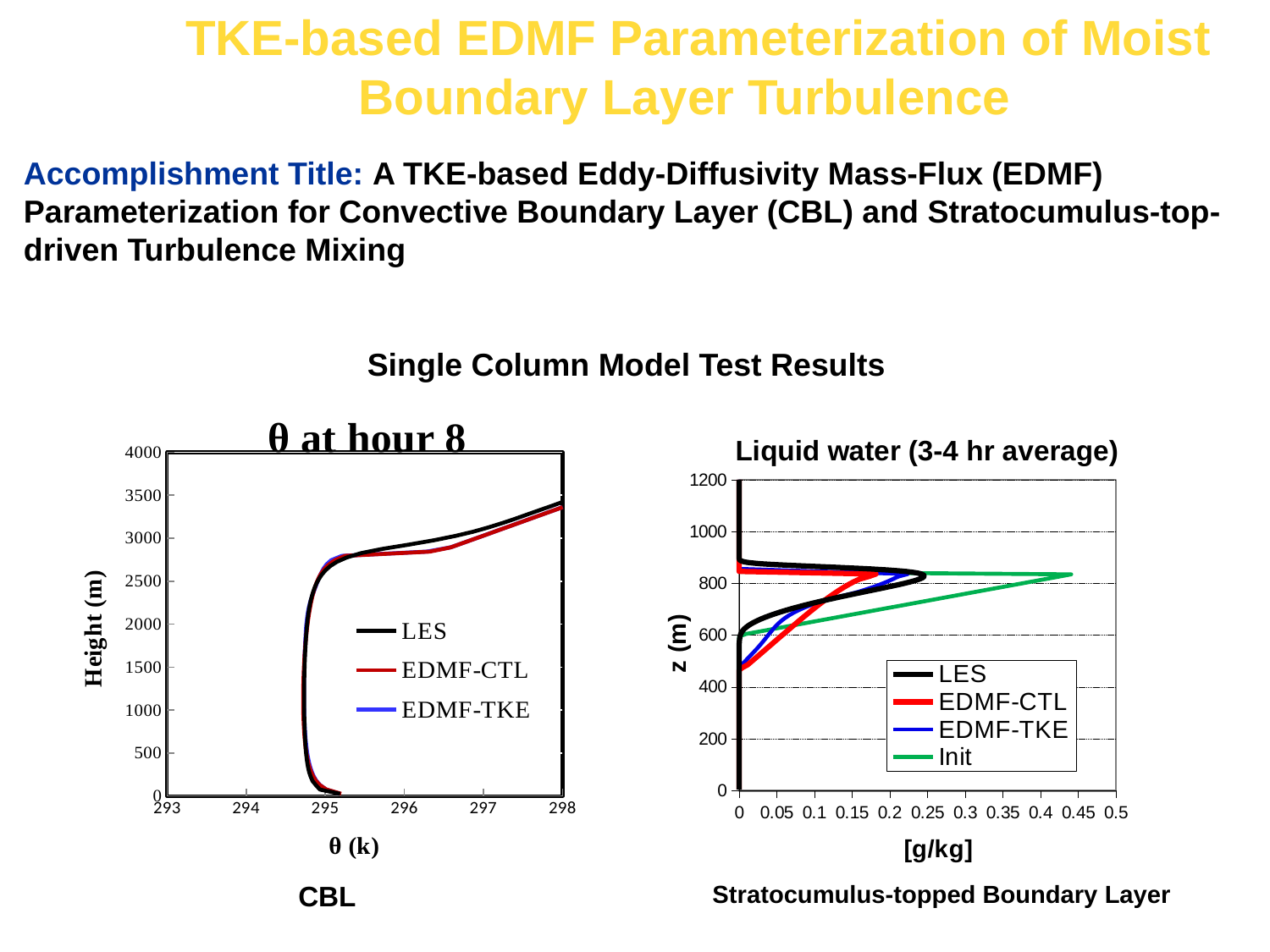
How many series does the legend of the left chart "θ at hour 8" list? 3 In the right chart "Liquid water (3-4 hr average)", is the peak value of the LES series greater or less than 0.3 g/kg? less How many series does the legend of the right chart "Liquid water (3-4 hr average)" list? 4 In the left chart "θ at hour 8", is the LES value of θ at a height of 3000 m greater or less than 296 k? greater In the left chart "θ at hour 8", does θ rise or fall as height increases from 2500 m to 3500 m? rise In the right chart "Liquid water (3-4 hr average)", which series reaches the highest liquid water value? Init What kind of chart is the right chart titled "Liquid water (3-4 hr average)"? line chart What is the y-axis label of the left chart "θ at hour 8"? Height (m) What kind of chart is the left chart titled "θ at hour 8"? line chart In the right chart "Liquid water (3-4 hr average)", which has a larger peak liquid water value, LES or EDMF-CTL? LES What is the x-axis label of the right chart "Liquid water (3-4 hr average)"? [g/kg] In the right chart "Liquid water (3-4 hr average)", is the peak value of the Init series greater or less than 0.4 g/kg? greater